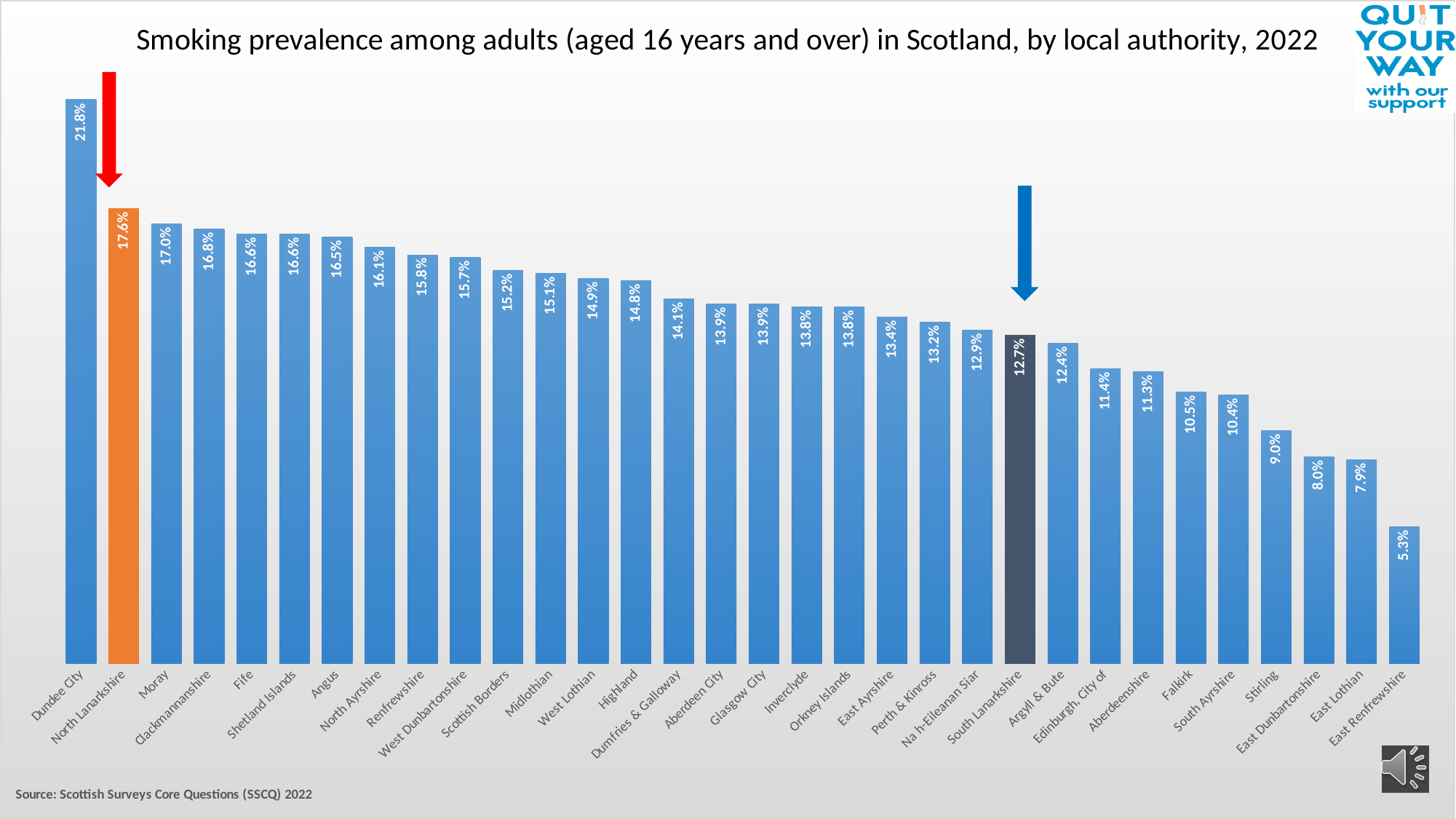
What is the difference in smoking prevalence between North Lanarkshire and South Lanarkshire? 4.9% Which local authority's bar is coloured orange? North Lanarkshire What is the smoking prevalence for Dundee City? 21.8% What type of chart is shown on the slide? Bar chart Do the values rise or fall from left to right along the x axis? Fall What is the smoking prevalence for South Lanarkshire? 12.7% Which local authority has the lowest smoking prevalence? East Renfrewshire What is the smoking prevalence for North Lanarkshire? 17.6% Which local authority has the highest smoking prevalence? Dundee City How many local authorities are shown in the chart? 32 Which has a higher smoking prevalence, Falkirk or Stirling? Falkirk What is the smoking prevalence for Glasgow City? 13.9%